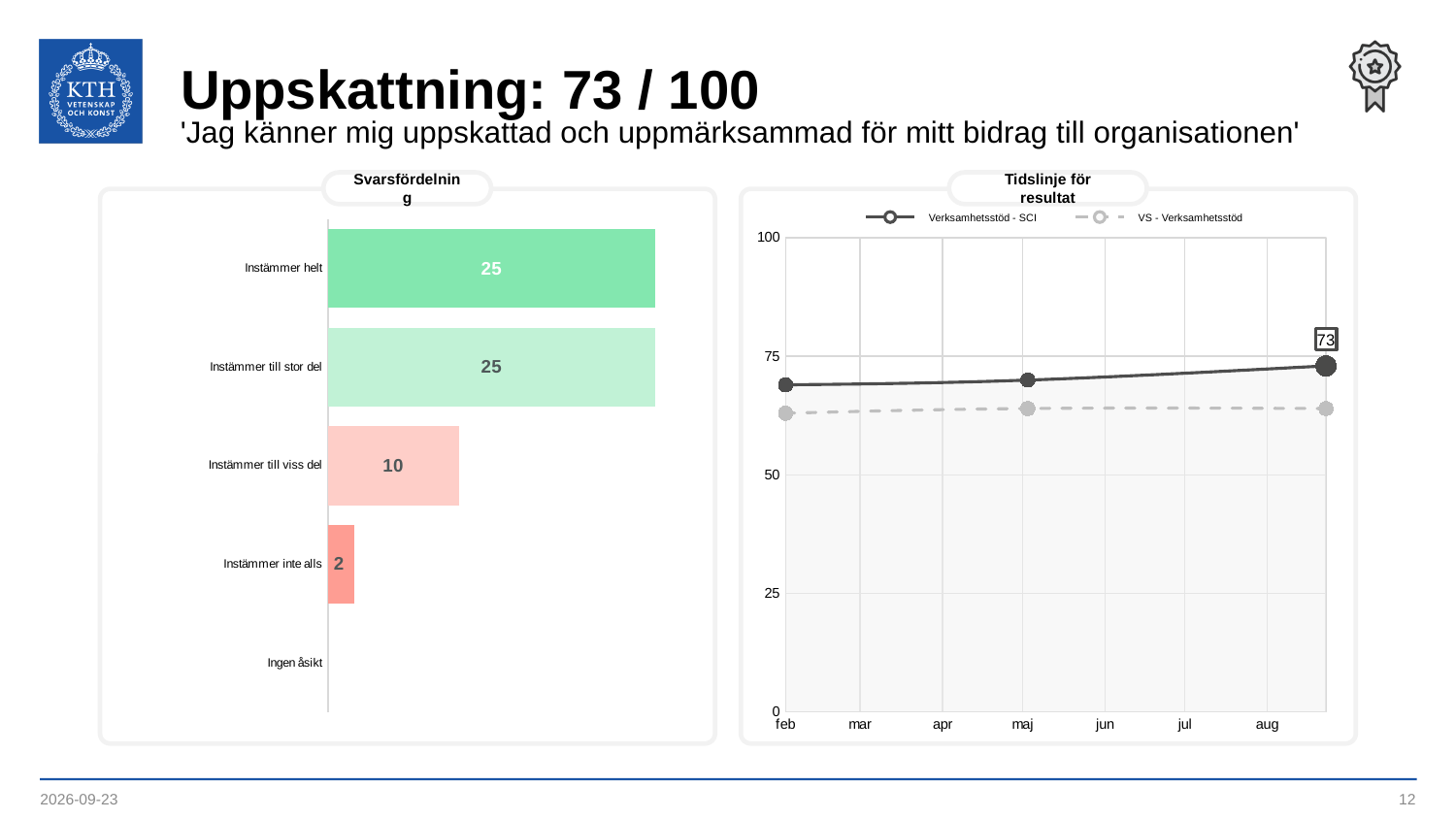
How many series does the legend of the Tidslinje för resultat chart list? 2 In the Svarsfördelning chart, which is larger: Instämmer till viss del or Instämmer inte alls? Instämmer till viss del In the Tidslinje för resultat chart, is the value of the VS - Verksamhetsstöd series in feb greater or less than 75? less In the Tidslinje för resultat chart, what is the labelled value of the last point of the Verksamhetsstöd - SCI series? 73 In the Svarsfördelning chart, what is the value for Instämmer till viss del? 10 What kind of chart is the Svarsfördelning chart? Bar chart How many categories are listed on the Svarsfördelning chart? 5 In the Tidslinje för resultat chart, does the Verksamhetsstöd - SCI series rise or fall from feb to the last point? rise What is the title of the chart on the right side of the slide? Tidslinje för resultat In the Svarsfördelning chart, what is the value for Instämmer helt? 25 In the Svarsfördelning chart, what is the value for Instämmer inte alls? 2 In the Svarsfördelning chart, what is the difference between the values for Instämmer helt and Instämmer till viss del? 15